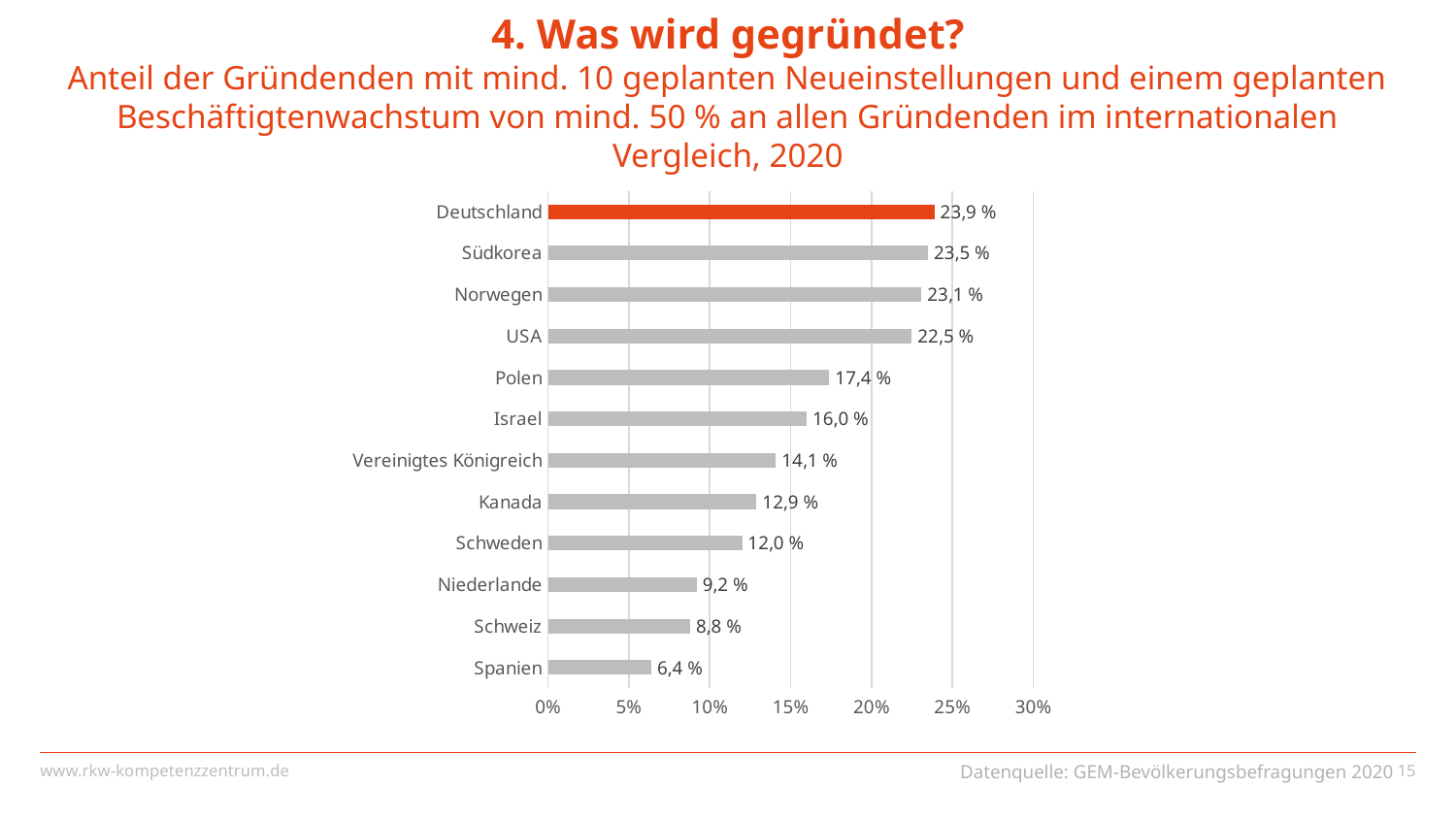
What is the value for Polen? 17,4 % Which country's bar is highlighted in a different colour (orange) from the others? Deutschland What is the value for Schweiz? 8,8 % Which has a larger value, Norwegen or USA? Norwegen What kind of chart is shown on the slide? bar chart What is the difference between the values for Deutschland and Spanien? 17,5 % What is the value for Deutschland? 23,9 % Which country has the highest value? Deutschland What is the difference between the values for Israel and Kanada? 3,1 % How many countries are shown in the chart? 12 Is the value for Vereinigtes Königreich greater or less than 15%? less Which country has the lowest value? Spanien